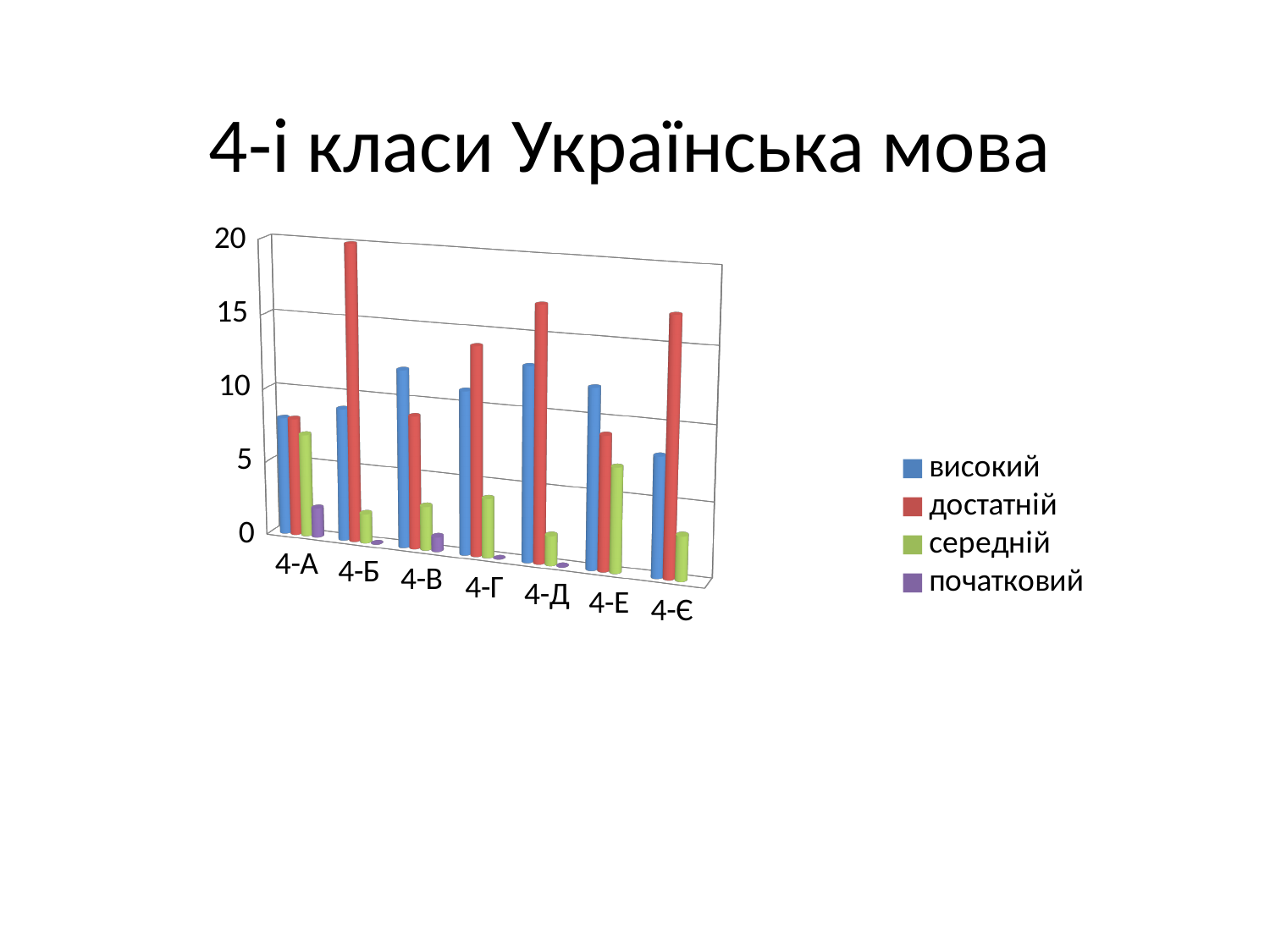
In 4-В, which is larger: високий or середній? високий Which class has the highest value for достатній? 4-Б What is the title of the chart? 4-і класи Українська мова Which series is shown in purple in the legend? початковий Is the value for достатній in 4-Б greater or less than 15? greater Is the value for достатній in 4-Д greater or less than 10? greater What kind of chart is shown on the slide? bar chart Is the value for високий in 4-Є greater or less than 10? less How many series does the legend list? 4 In 4-Є, which is larger: високий or достатній? достатній How many classes (categories) are shown on the x axis? 7